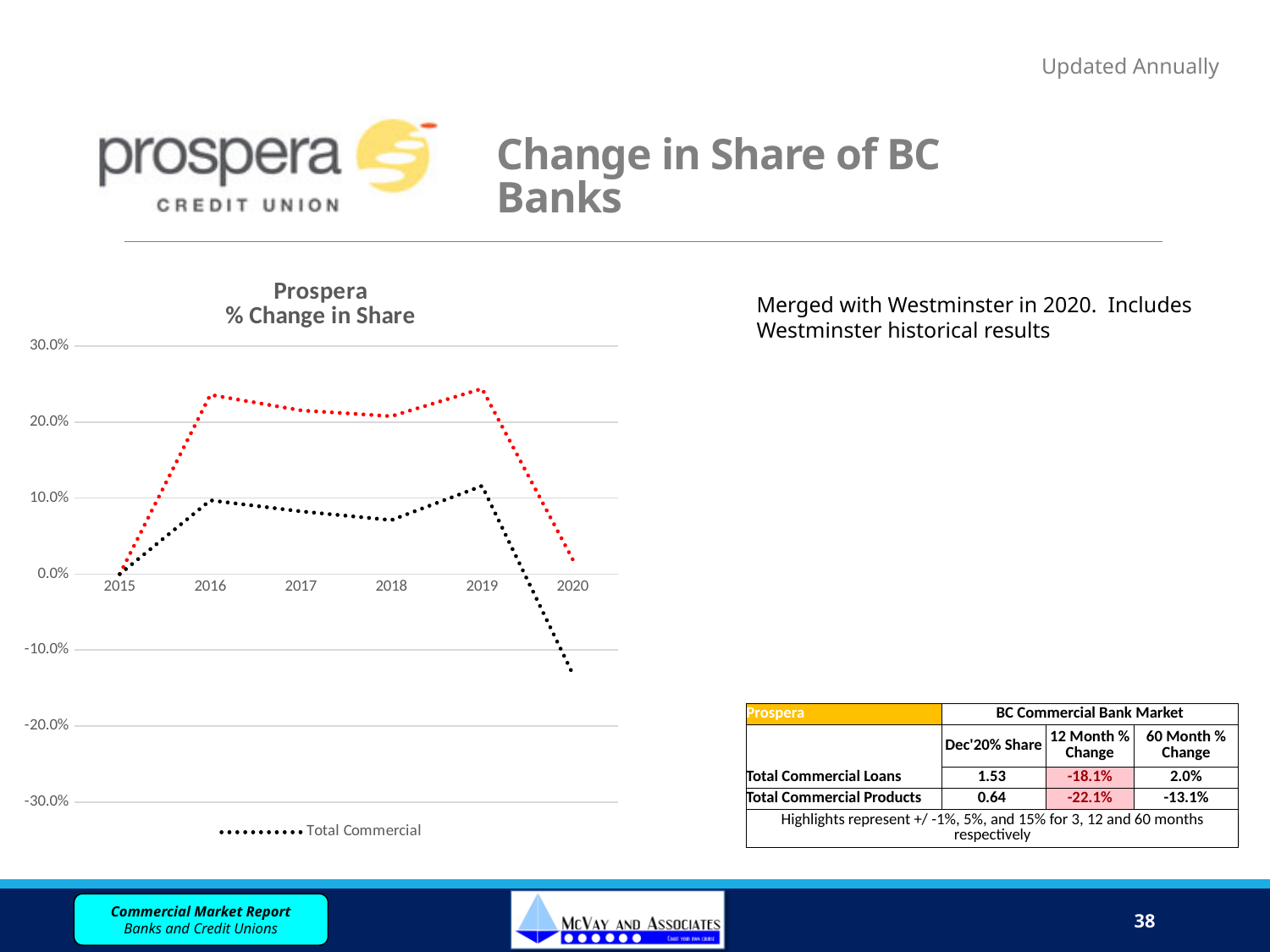
Is the value of the red dotted line for 2020 greater or less than 10.0%? less Is the value of the black dotted line for 2019 greater or less than 0.0%? greater Is the value of the black dotted line for 2020 greater or less than -10.0%? less What is the first year shown on the x axis of the chart? 2015 How many years are plotted along the x axis of the chart? 6 What kind of chart is shown on the slide? line chart Do the plotted lines rise or fall from 2019 to 2020? fall What is the title of the chart? Prospera % Change in Share In which year does the black dotted line reach its lowest value? 2020